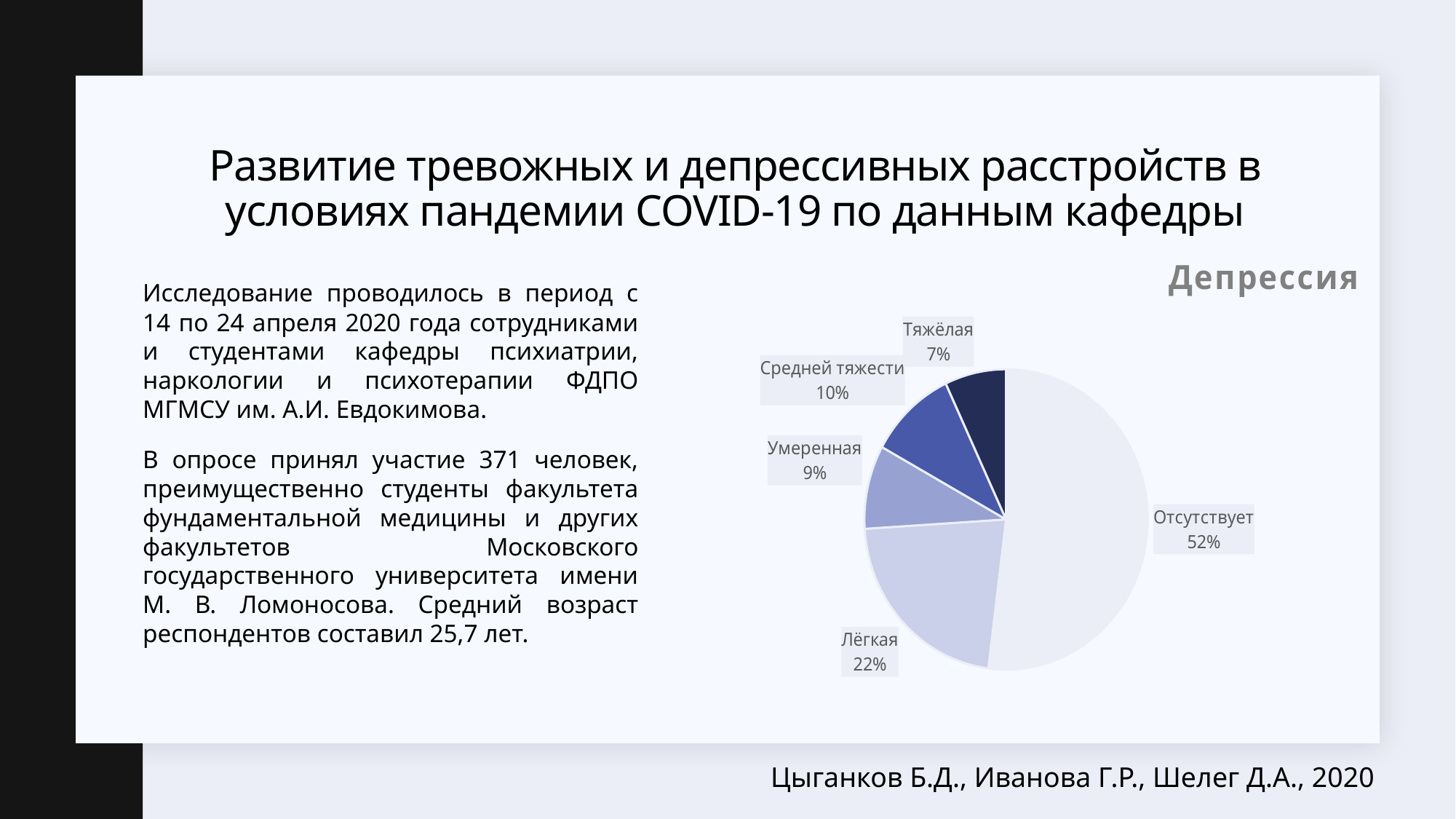
Which category has the largest slice? Отсутствует What is the value for 'Средней тяжести'? 10% What is the difference between the 'Отсутствует' and 'Лёгкая' values? 30% What is the value for 'Умеренная'? 9% What is the value for 'Тяжёлая'? 7% What share of the pie does the 'Отсутствует' slice represent? 52% Which category has the smallest slice? Тяжёлая Which is larger, 'Средней тяжести' or 'Тяжёлая'? Средней тяжести What is the value for 'Лёгкая'? 22% What is the title of the chart? Депрессия How many categories are shown in the pie chart? 5 What type of chart is shown on the slide? pie chart